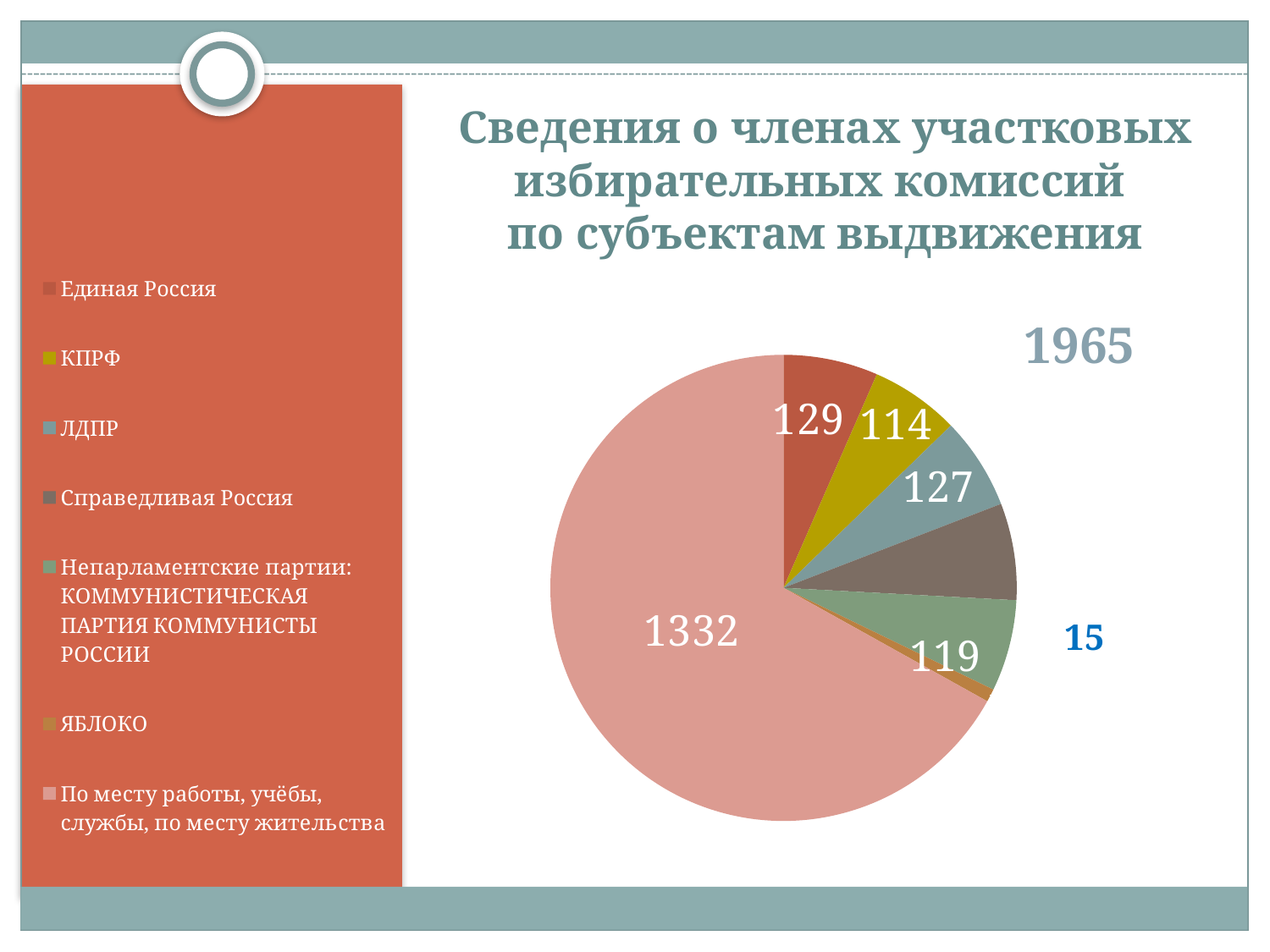
How many categories does the legend list? 7 What is the value for Непарламентские партии: КОММУНИСТИЧЕСКАЯ ПАРТИЯ КОММУНИСТЫ РОССИИ? 119 Which category has the smallest slice of the pie? ЯБЛОКО Which category has the largest slice of the pie? По месту работы, учёбы, службы, по месту жительства What type of chart is shown on the slide? pie chart Which is larger, the value for ЛДПР or the value for КПРФ? ЛДПР What is the value for ЛДПР? 127 What is the value for Единая Россия? 129 What is the value for ЯБЛОКО? 15 What is the value for КПРФ? 114 What is the difference between the values for Единая Россия and КПРФ? 15 What is the value for По месту работы, учёбы, службы, по месту жительства? 1332